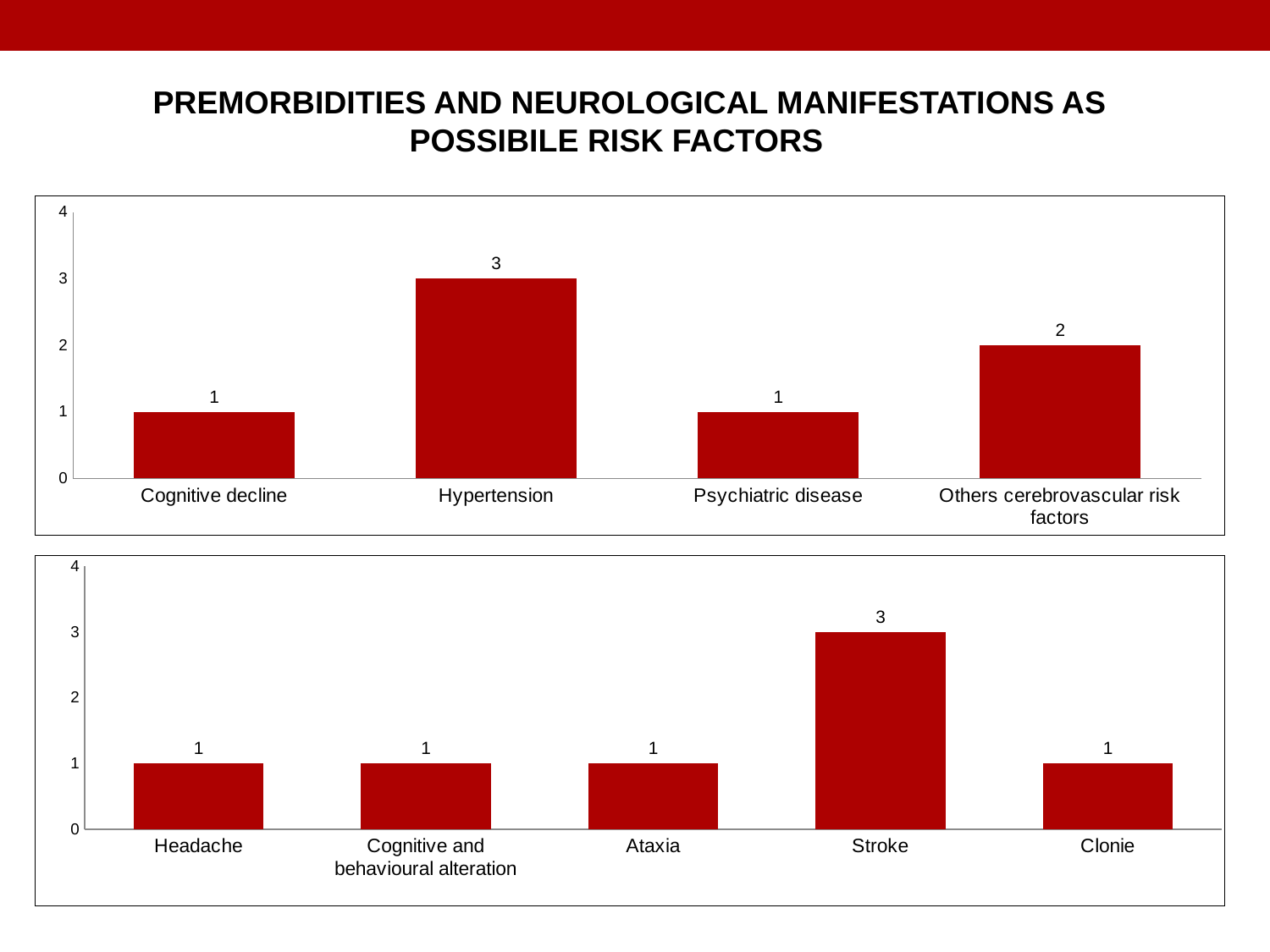
In the top chart, how many categories are shown? 4 In the bottom chart, which category has the highest value? Stroke In the bottom chart, what is the value for Stroke? 3 In the top chart, which category has the highest value? Hypertension What kind of chart is the bottom chart? Bar chart In the bottom chart, what is the value for Ataxia? 1 In the bottom chart, what is the difference between Stroke and Clonie? 2 In the top chart, what is the value for Others cerebrovascular risk factors? 2 In the top chart, what is the difference between Hypertension and Cognitive decline? 2 In the top chart, which is larger, Psychiatric disease or Others cerebrovascular risk factors? Others cerebrovascular risk factors In the bottom chart, how many categories are shown? 5 In the top chart, what is the value for Hypertension? 3